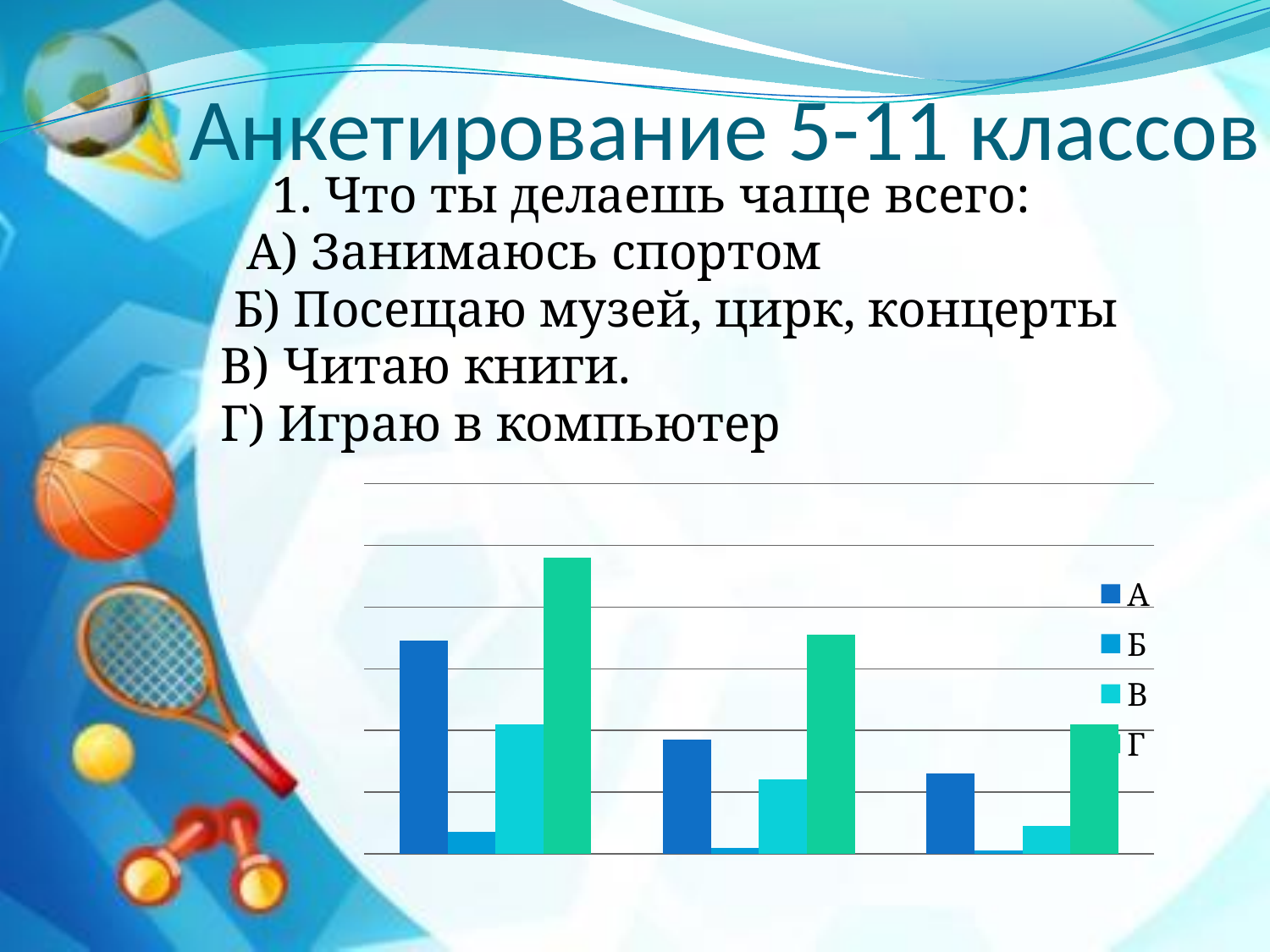
Which series has the shortest bar in the first (leftmost) group of bars? Б Which series has the tallest bar in the first (leftmost) group of bars? Г In the first group of bars, which is larger: the bar for А or the bar for В? А In the third group of bars, which is larger: the bar for Г or the bar for А? Г What colour are the bars for series Г in the chart? green Do the bars for series Г rise or fall from the first group to the third group? fall How many groups of bars are plotted in the chart? 3 What kind of chart is shown on the slide? bar chart What are the entries listed in the chart's legend? А, Б, В, Г How many series does the chart's legend list? 4 Which series has the tallest bar in the second (middle) group of bars? Г Which series has the shortest bar in the third (rightmost) group of bars? Б